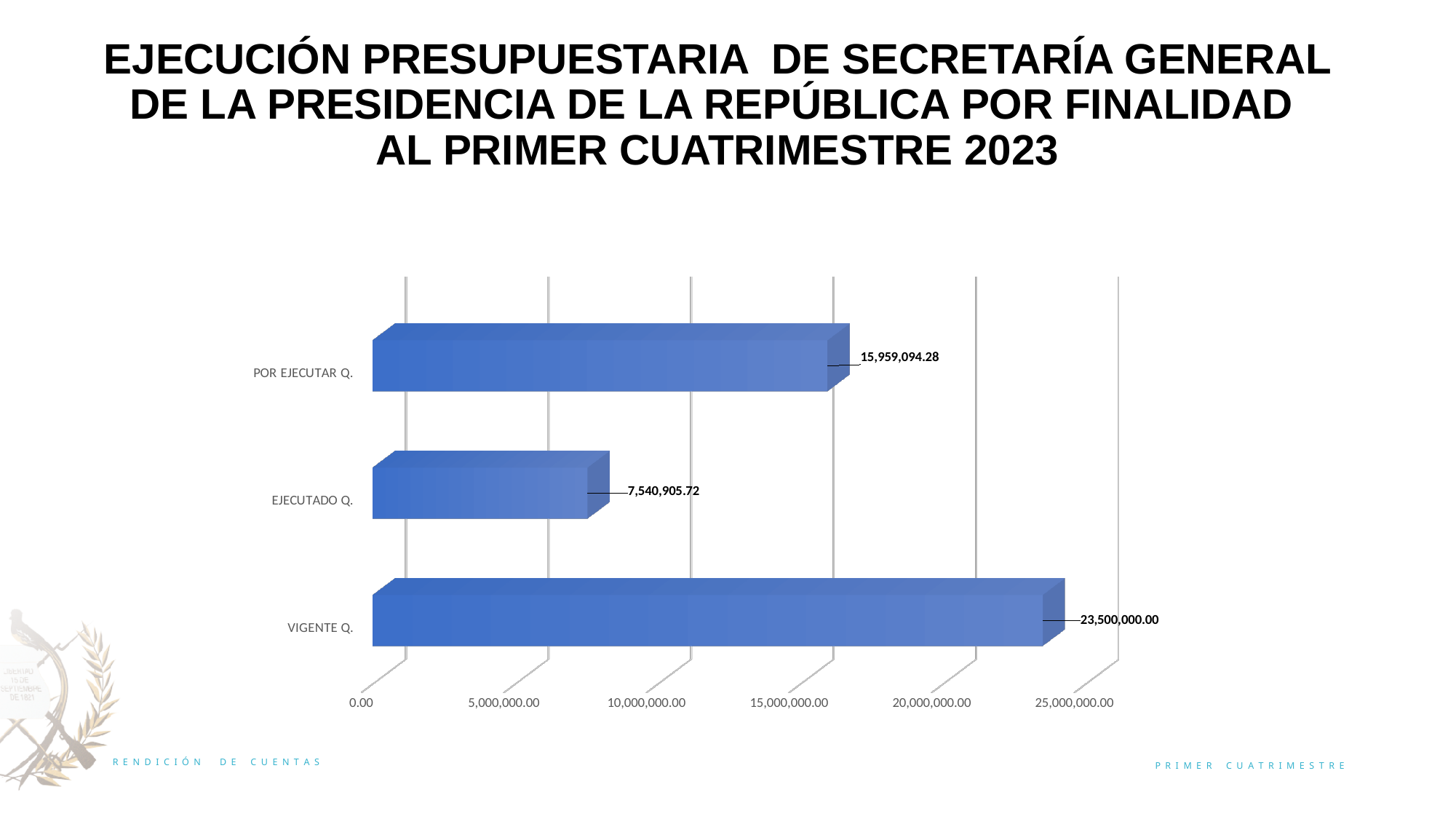
What is the value for EJECUTADO Q.? 7,540,905.72 What is the difference between VIGENTE Q. and EJECUTADO Q.? 15,959,094.28 What is the value for POR EJECUTAR Q.? 15,959,094.28 Which category has the lowest value? EJECUTADO Q. Which category has the highest value? VIGENTE Q. Which is larger, POR EJECUTAR Q. or EJECUTADO Q.? POR EJECUTAR Q. How many categories are shown in the chart? 3 What is the difference between POR EJECUTAR Q. and EJECUTADO Q.? 8,418,188.56 Is the value for EJECUTADO Q. greater or less than 10,000,000.00? less What kind of chart is shown on the slide? Bar chart What is the highest value shown on the horizontal axis? 25,000,000.00 What is the value for VIGENTE Q.? 23,500,000.00